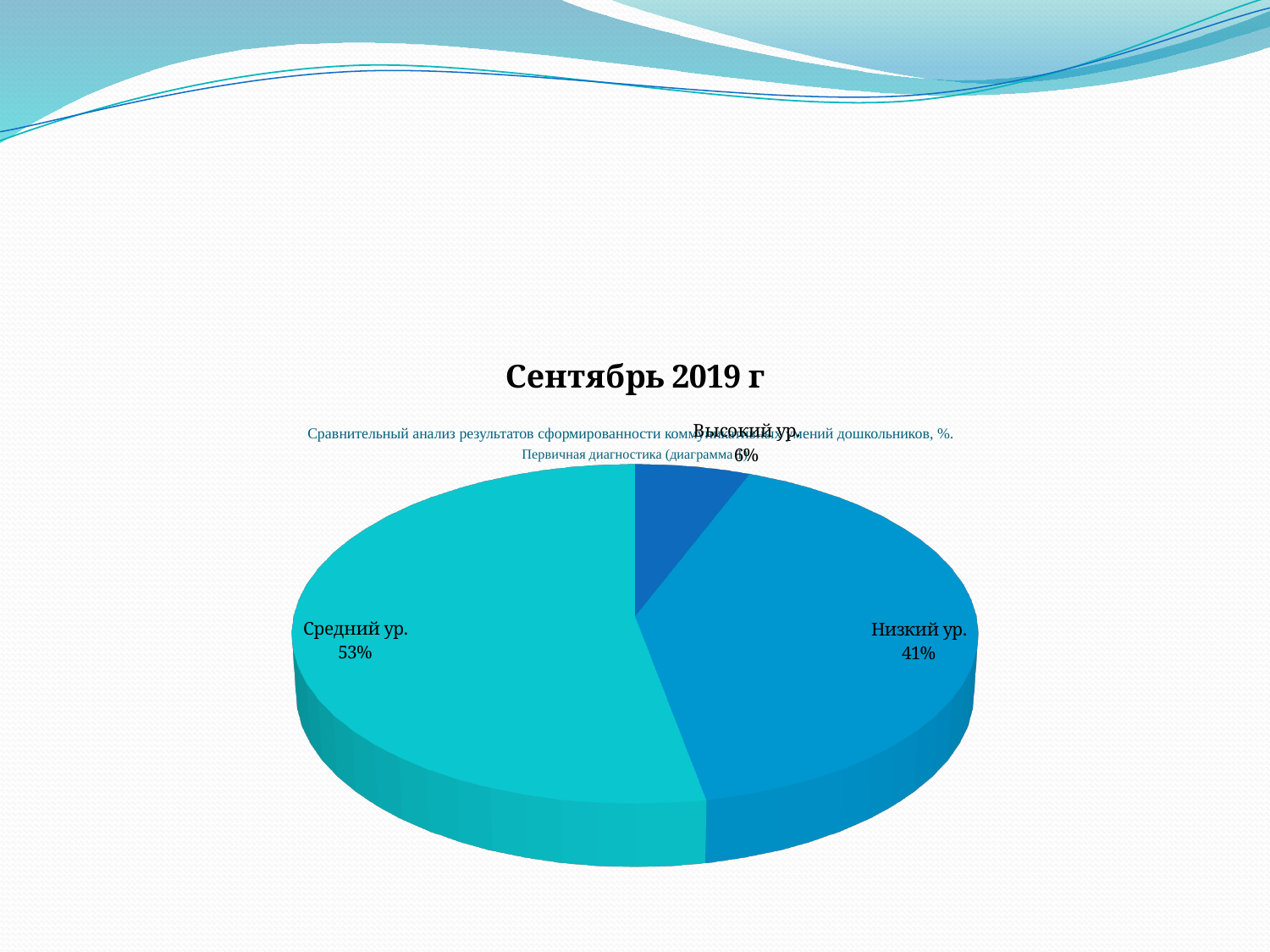
What share of the pie does Средний ур. represent? 53% What is the difference between the values for Низкий ур. and Высокий ур.? 35% What is the difference between the values for Средний ур. and Низкий ур.? 12% What is the title of the chart? Сентябрь 2019 г What is the value for Низкий ур.? 41% Which category has the smallest share of the pie? Высокий ур. Which category has the largest share of the pie? Средний ур. How many slices does the pie chart have? 3 What kind of chart is shown on the slide? pie chart Which is larger, the value for Низкий ур. or the value for Высокий ур.? Низкий ур. What is the value for Высокий ур.? 6% What is the value for Средний ур.? 53%